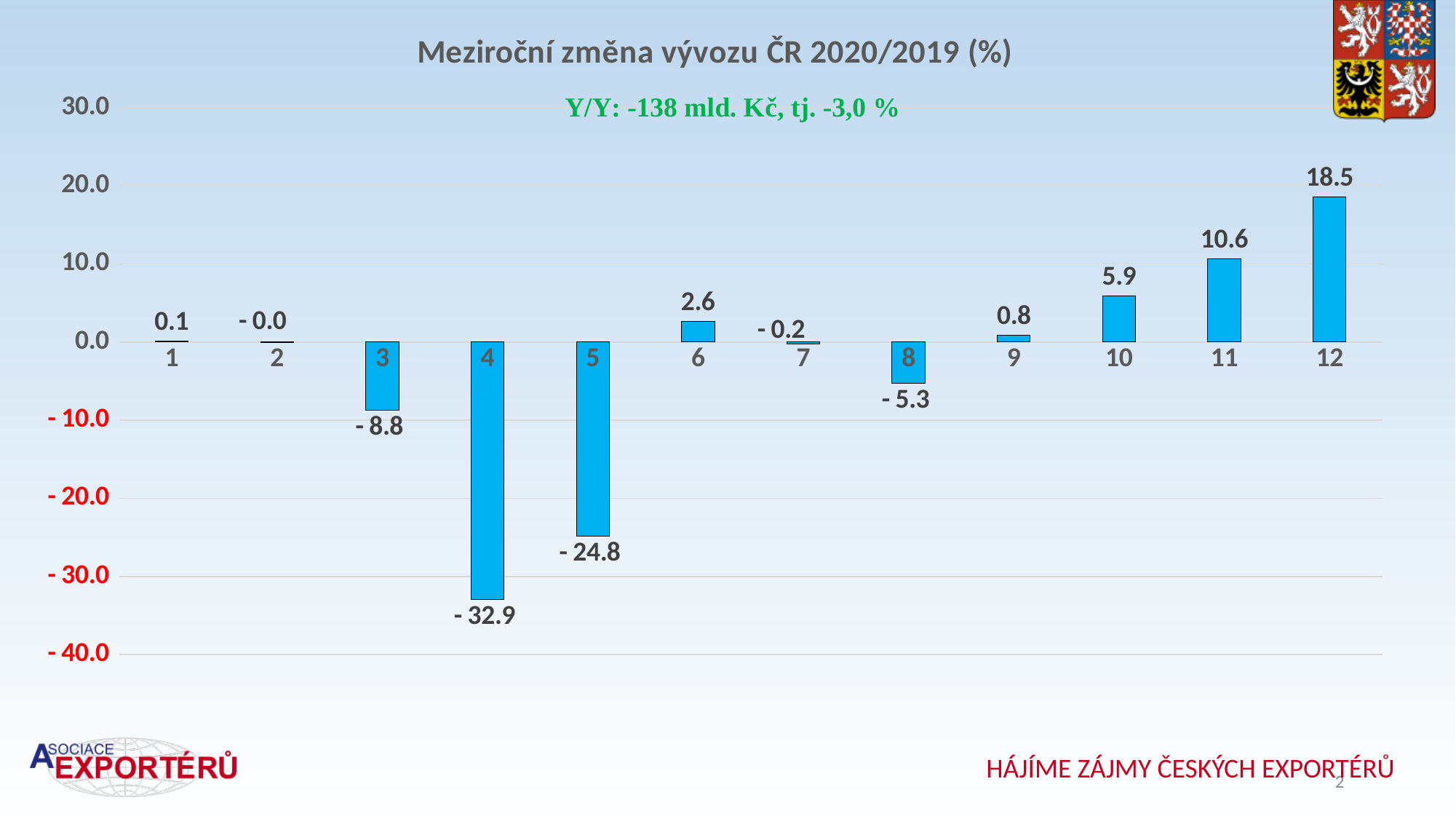
What is the value for month 8? -5.3 What is the value for month 12? 18.5 Is the value for month 5 greater or less than -20.0? less How many categories (months) are plotted on the x axis? 12 Do the values rise or fall from month 9 to month 12? rise What type of chart is shown on the slide? bar chart Which is larger, the value for month 10 or the value for month 6? month 10 What is the title of the chart? Meziroční změna vývozu ČR 2020/2019 (%) Which month has the highest value? 12 Which month has the lowest value? 4 What is the value for month 4? -32.9 What is the difference between the values for month 12 and month 11? 7.9